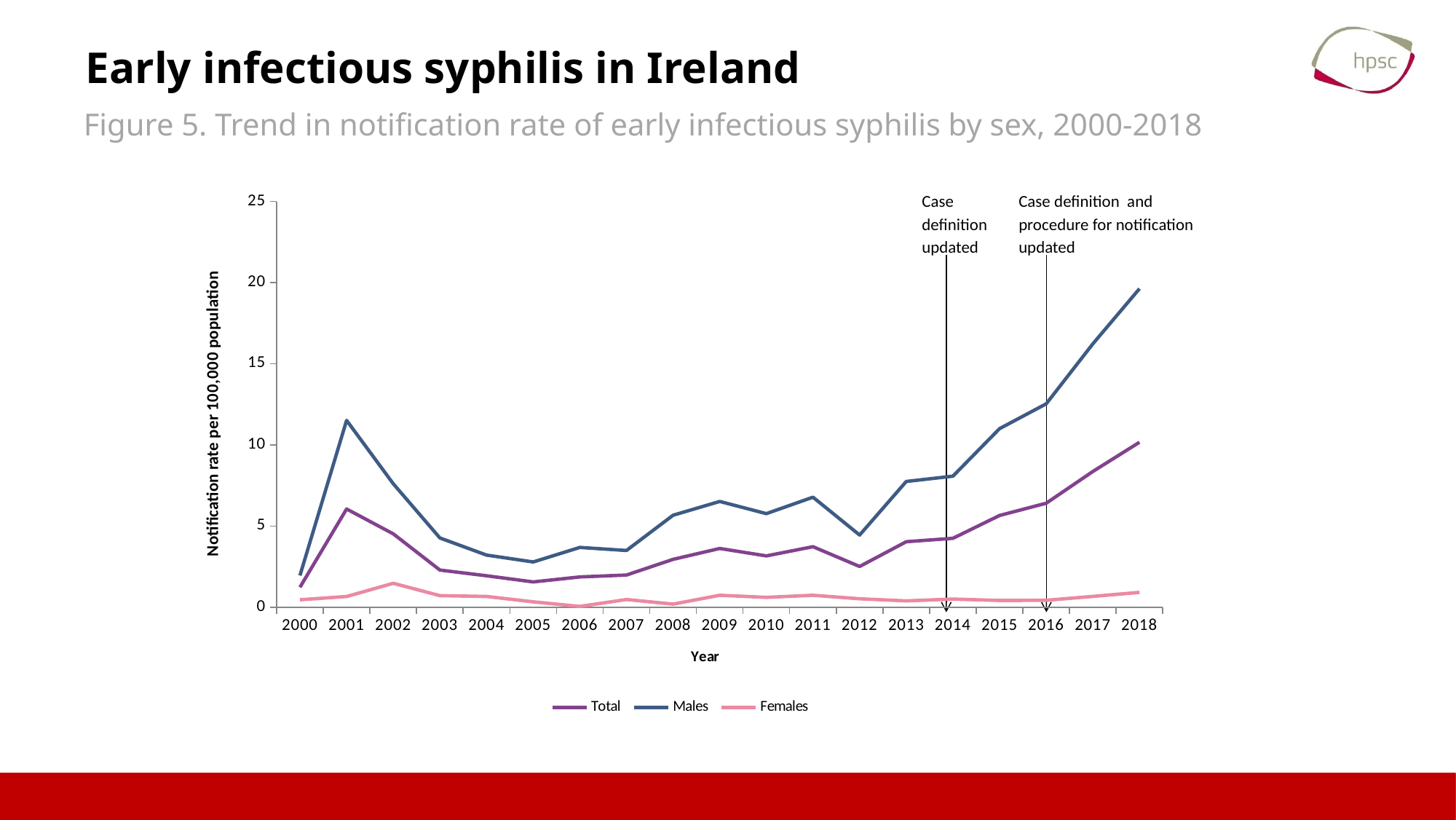
Does the notification rate for Males rise or fall from 2012 to 2018? rise How many series does the legend list? 3 In which year is the notification rate for Males highest? 2018 What kind of chart is shown on the slide? line chart Does the notification rate for Males rise or fall from 2001 to 2005? fall Is the value for Males in 2005 greater or less than 5? less Is the value for Males in 2001 greater or less than 10? greater What is the label of the y axis? Notification rate per 100,000 population How many years are plotted along the x axis? 19 In which year is the notification rate for Males lowest? 2000 Which series has the higher notification rate in 2018, Males or Females? Males Is the value for Males in 2018 greater or less than 15? greater